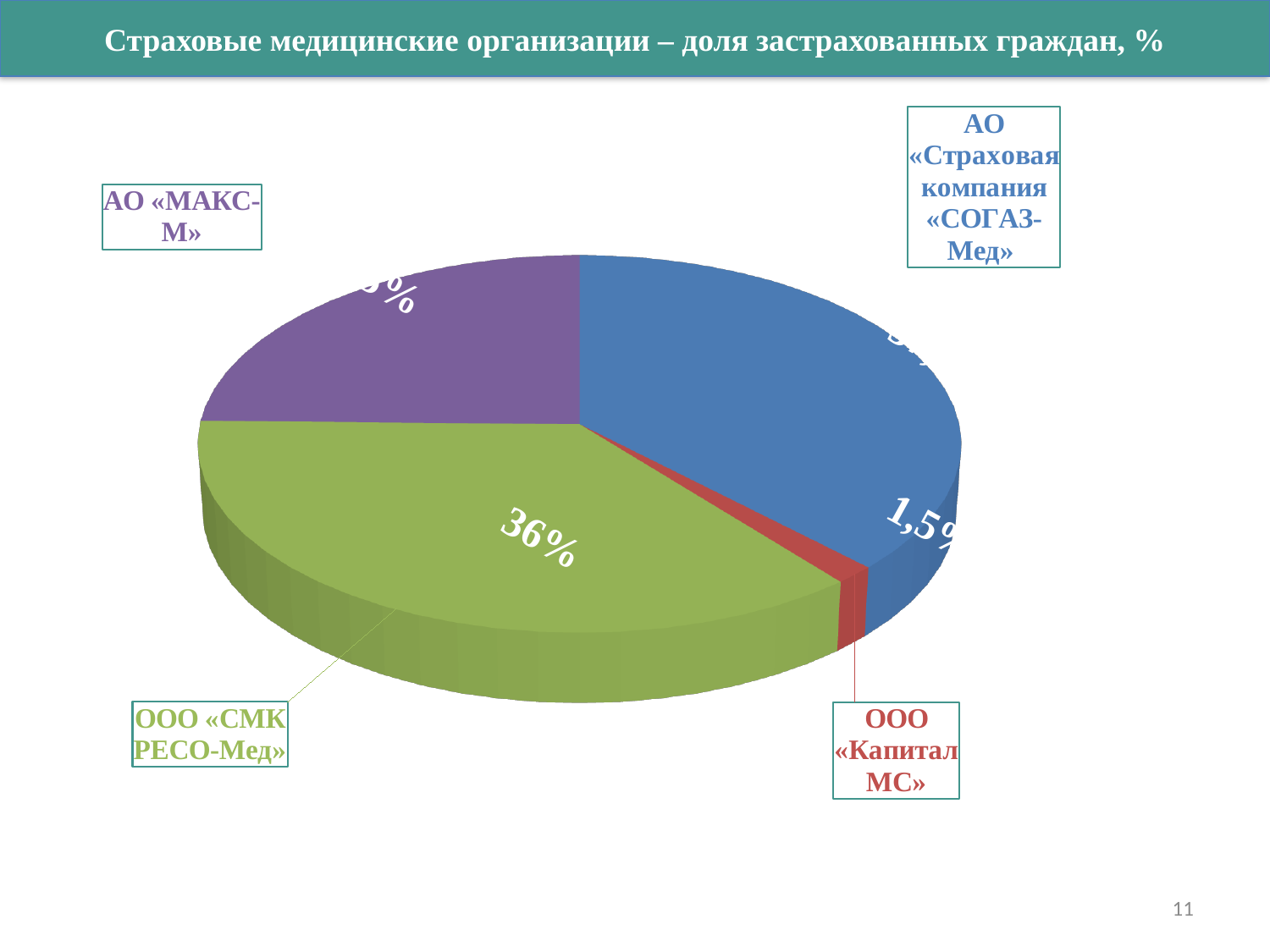
How many insurance organisations (slices) does the pie chart show? 4 Which has a larger share: АО «Страховая компания «СОГАЗ-Мед» or ООО «Капитал МС»? АО «Страховая компания «СОГАЗ-Мед» What colour is the slice for ООО «СМК РЕСО-Мед»? green Which has a larger share: ООО «СМК РЕСО-Мед» or ООО «Капитал МС»? ООО «СМК РЕСО-Мед» What is the title of the slide? Страховые медицинские организации – доля застрахованных граждан, % Which has a larger share: ООО «СМК РЕСО-Мед» or АО «МАКС-М»? ООО «СМК РЕСО-Мед» What is the difference in percentage points between the shares of ООО «СМК РЕСО-Мед» and ООО «Капитал МС»? 34,5% Which insurance organisation has the smallest share of insured citizens? ООО «Капитал МС» What share of insured citizens does ООО «СМК РЕСО-Мед» have? 36% What share of insured citizens does ООО «Капитал МС» have? 1,5% What kind of chart is shown on the slide? pie chart